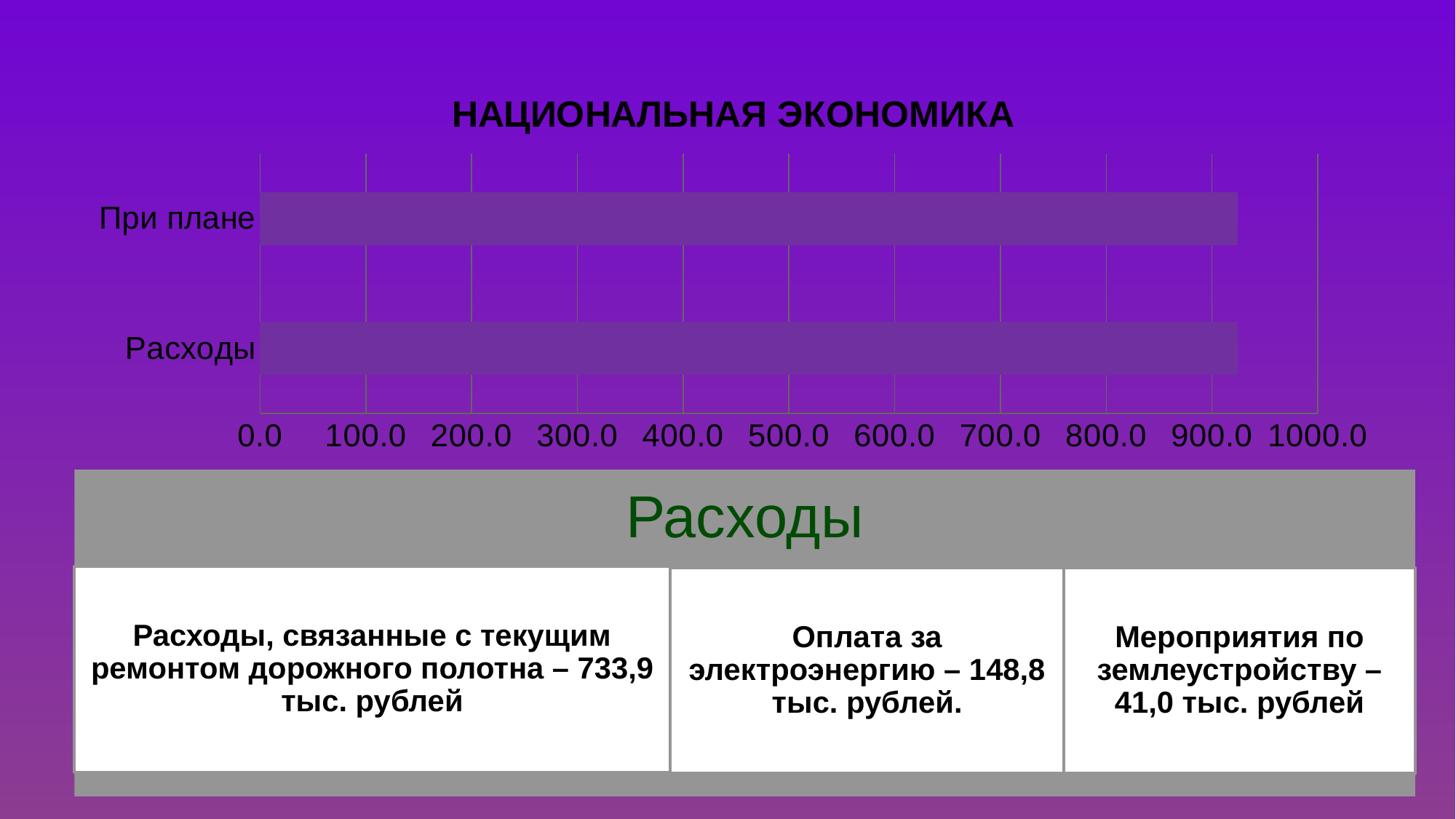
How many categories are plotted in the chart? 2 Is the value for При плане greater or less than 900.0? greater Is the value for Расходы greater or less than 500.0? greater Which category is listed at the top of the chart? При плане Is the value for Расходы greater or less than 900.0? greater What is the highest value shown on the horizontal axis of the chart? 1000.0 What is the title of the chart? НАЦИОНАЛЬНАЯ ЭКОНОМИКА What kind of chart is shown on the slide? bar chart